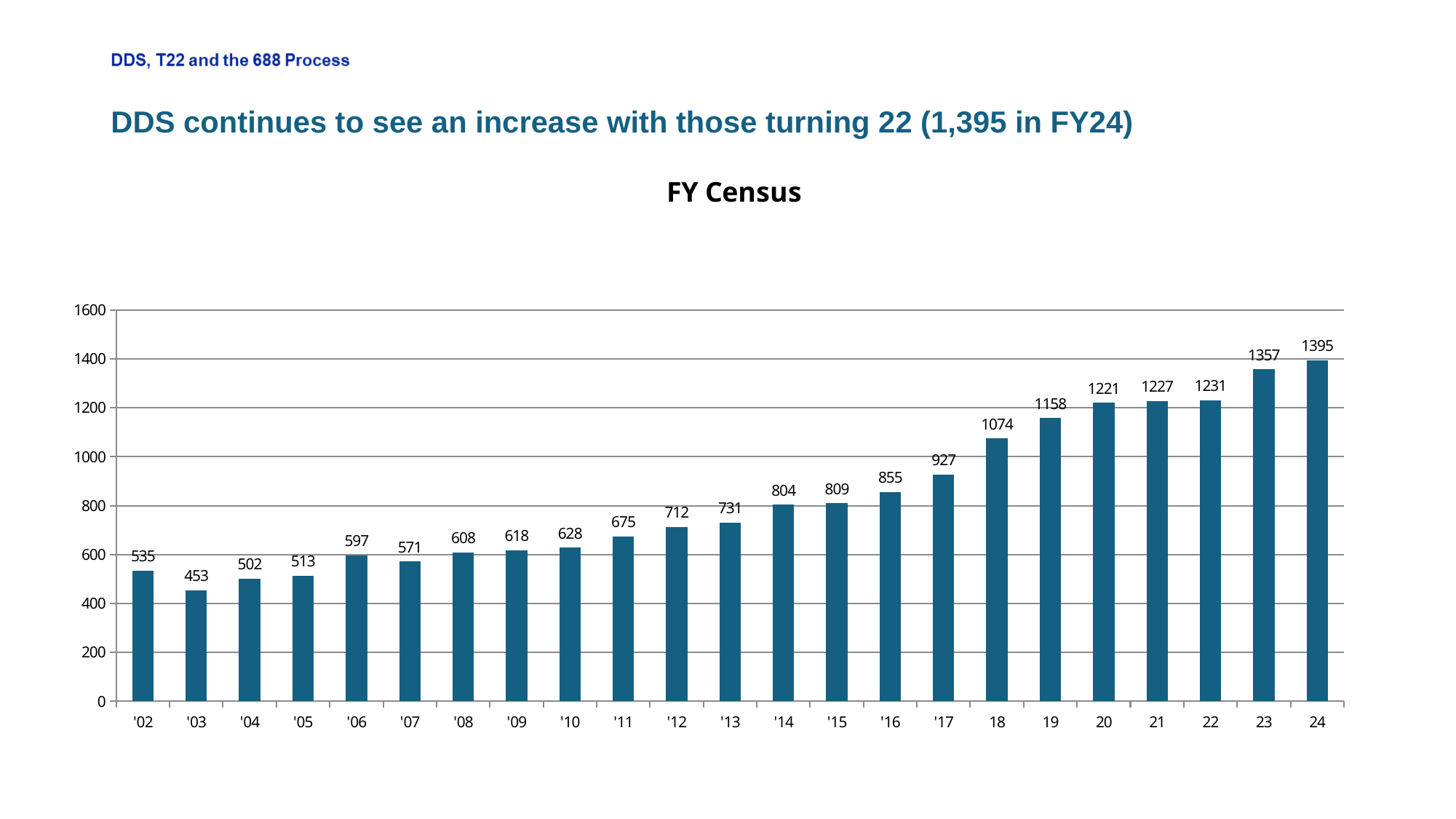
Which year has the lowest FY Census value? '03 Do the FY Census values generally rise or fall from '03 to 24? rise What kind of chart is the FY Census chart? bar chart Is the FY Census value for 18 greater or less than 1000? greater What is the difference between the FY Census values for '06 and '07? 26 What is the FY Census value for 20? 1221 What is the difference between the FY Census values for 24 and 23? 38 Which is larger, the FY Census value for '14 or for '15? '15 How many years are shown on the x axis of the FY Census chart? 23 What is the FY Census value for '02? 535 What is the FY Census value for '17? 927 Which year has the highest FY Census value? 24